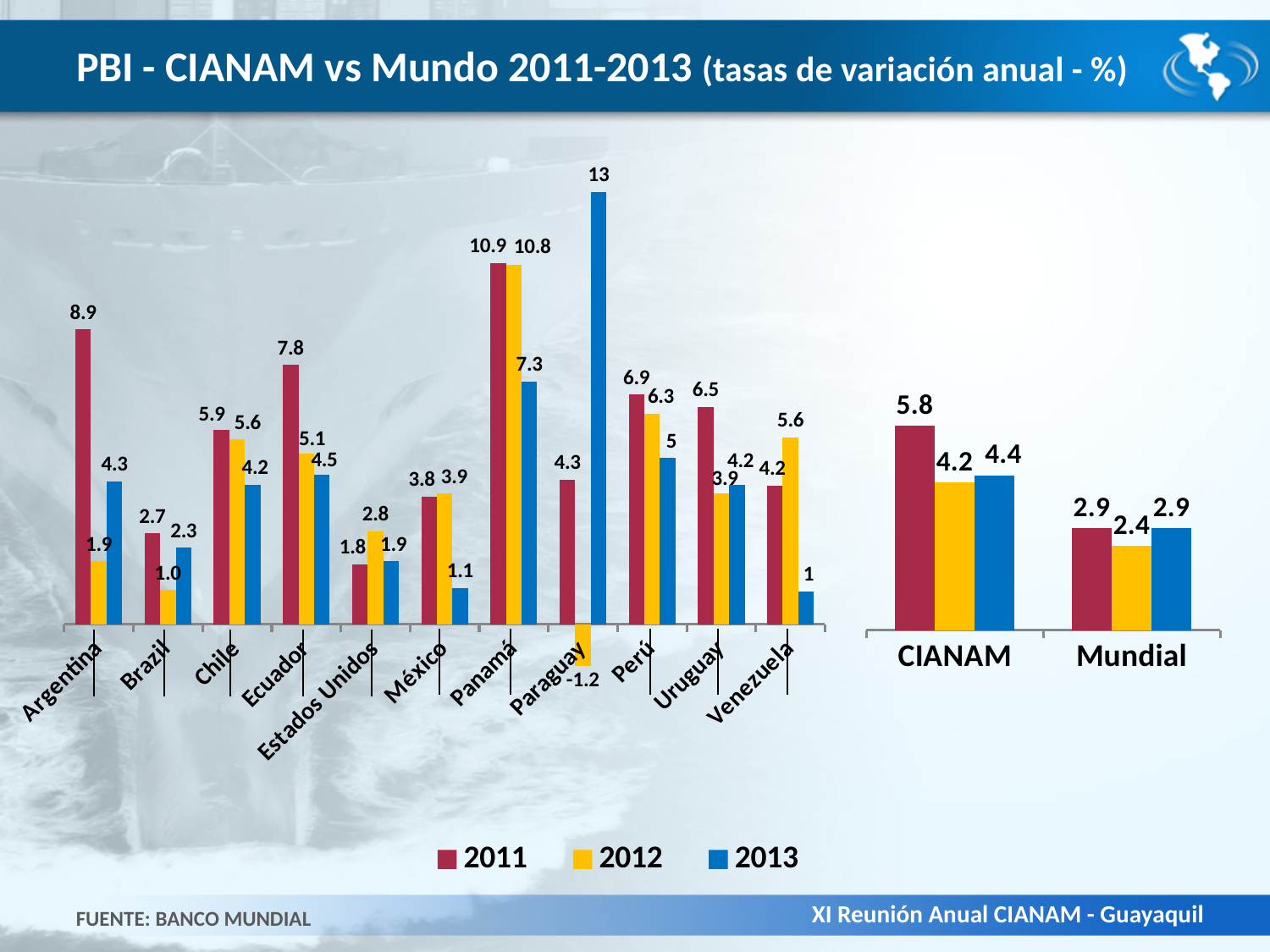
In the left chart (by country), what is the 2013 value for Paraguay? 13 How many series does the legend list? 3 In the left chart (by country), what is the 2012 value for Panamá? 10.8 In the left chart (by country), what is the 2011 value for Argentina? 8.9 In the left chart (by country), which country has the lowest 2012 value? Paraguay In the right chart (CIANAM vs Mundial), what is the difference between the 2013 values for CIANAM and Mundial? 1.5 What kind of chart is the left chart (by country)? Bar chart In the left chart (by country), how many countries are shown? 11 In the right chart (CIANAM vs Mundial), what is the 2011 value for CIANAM? 5.8 In the left chart (by country), what is the difference between the 2011 and 2013 values for Ecuador? 3.3 In the left chart (by country), which is larger: the 2012 value for Venezuela or the 2012 value for Uruguay? Venezuela In the left chart (by country), which country has the highest 2011 value? Panamá